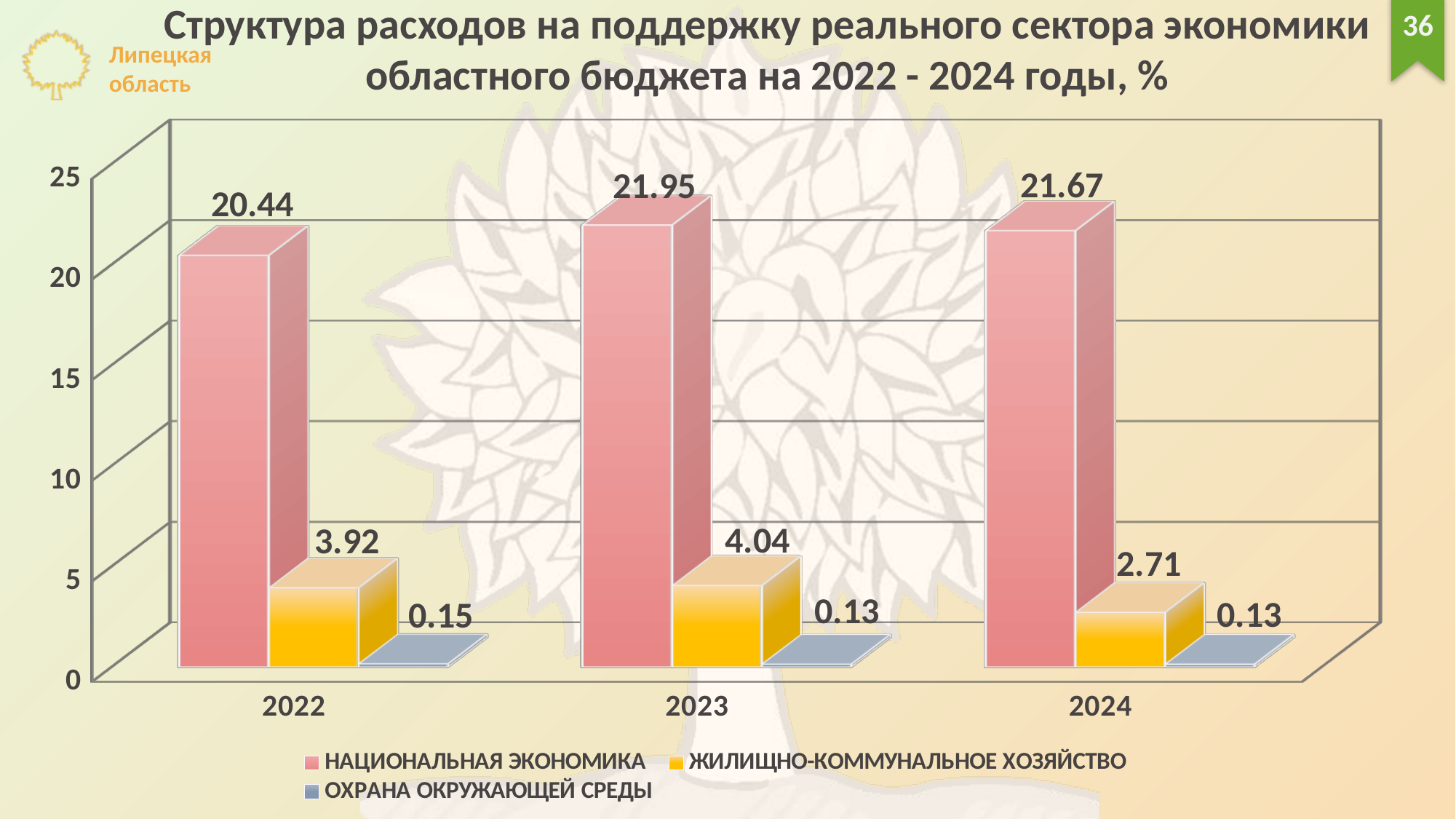
Какое значение у серии «Национальная экономика» в 2022 году? 20.44 Какого типа эта диаграмма? Столбчатая (bar chart) Сколько серий перечислено в легенде? 3 Какое значение у серии «Охрана окружающей среды» в 2022 году? 0.15 Что больше: значение «Национальная экономика» в 2024 году или в 2022 году? 2024 Сколько лет (категорий) показано на оси x? 3 В каком году значение серии «Национальная экономика» наибольшее? 2023 Какое значение у серии «Жилищно-коммунальное хозяйство» в 2024 году? 2.71 На сколько значение серии «Жилищно-коммунальное хозяйство» в 2023 году больше, чем в 2024 году? 1.33 В каком году значение серии «Жилищно-коммунальное хозяйство» наименьшее? 2024 Каким цветом обозначена серия «Охрана окружающей среды» в легенде? Серо-голубым На сколько значение серии «Национальная экономика» в 2023 году больше, чем в 2022 году? 1.51